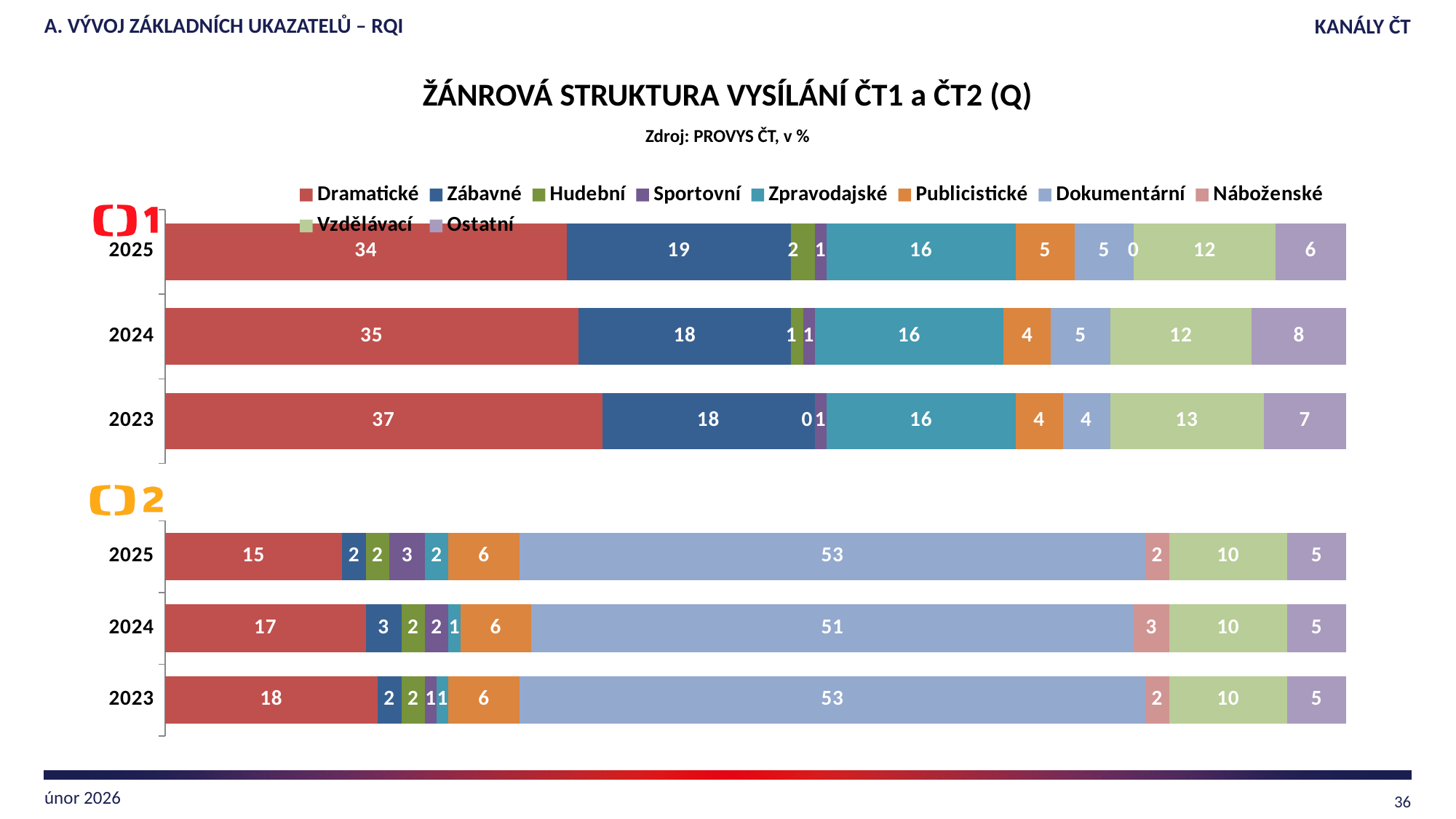
How many years are shown in the ČT2 chart (bottom)? 3 In the ČT1 chart (top), does the Dramatické share rise or fall from 2023 to 2025? Fall In the ČT2 chart (bottom), what is the total of the 2025 bar? 100 In the ČT1 chart (top), what is the difference between the Dramatické values for 2023 and 2025? 3 In the ČT1 chart (top), which genre has the largest share in 2024? Dramatické How many series does the legend list? 10 In the ČT2 chart (bottom), what is the value for Dokumentární in 2024? 51 In the ČT1 chart (top), what is the value for Vzdělávací in 2023? 13 In the ČT2 chart (bottom), which genre has the largest share in 2025? Dokumentární In the ČT1 chart (top), what is the value for Dramatické in 2025? 34 What kind of chart is used on this slide? Stacked bar chart In the ČT2 chart (bottom), which is larger in 2024: Dramatické or Publicistické? Dramatické